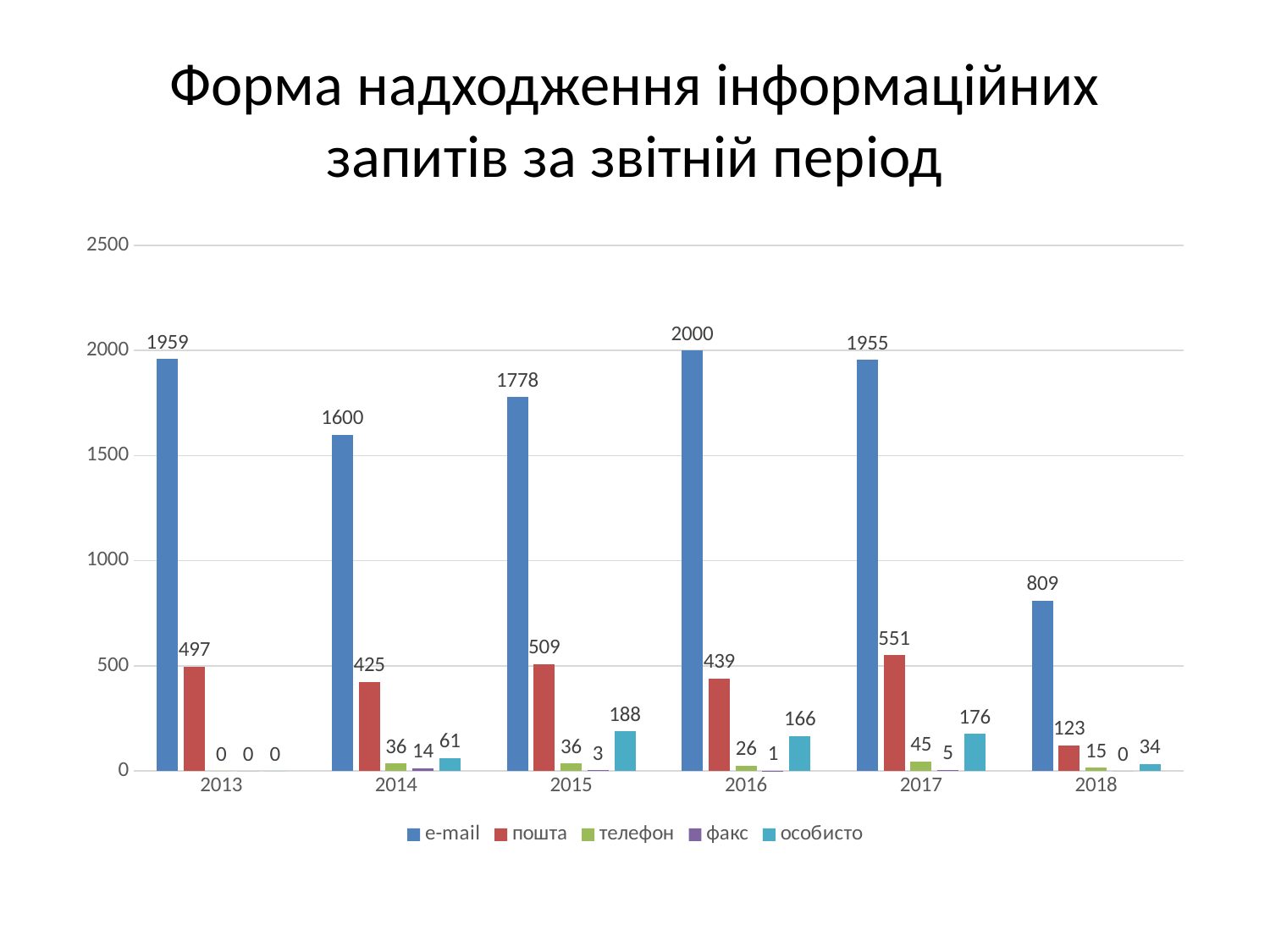
In which year is the e-mail value lowest? 2018 What is the value for факс in 2014? 14 In which year is the e-mail value highest? 2016 How many years are shown on the x axis? 6 Which is larger, the пошта value for 2015 or for 2016? 2015 What is the difference between the e-mail values for 2017 and 2018? 1146 What is the value for пошта in 2017? 551 Which series is shown in blue in the legend? e-mail What kind of chart is shown on the slide? bar chart How many series does the legend list? 5 What is the value for особисто in 2015? 188 What is the value for e-mail in 2016? 2000